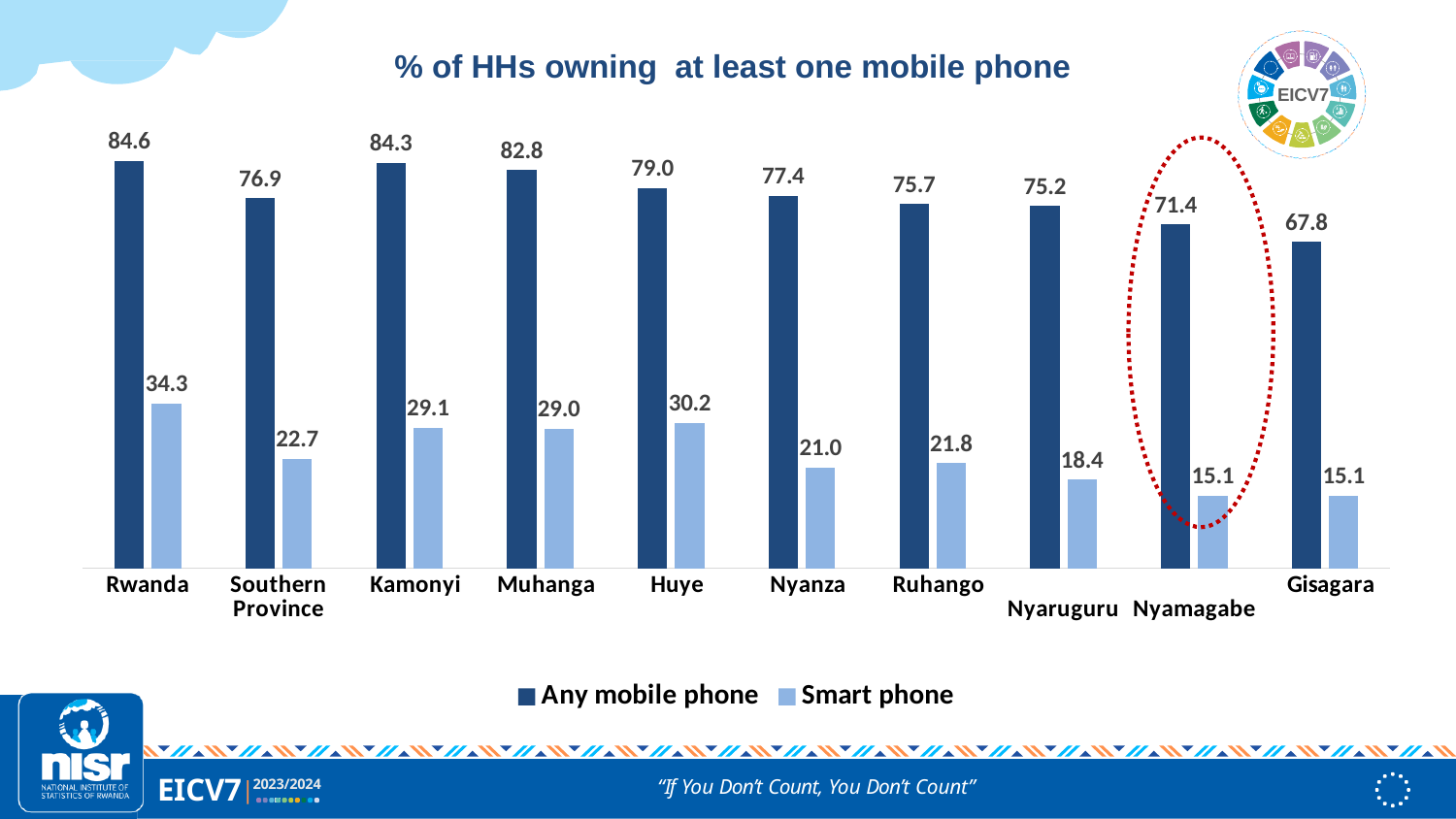
Which is larger, the Smart phone value for Kamonyi or for Nyanza? Kamonyi What is the value for Smart phone in Nyaruguru? 18.4 Which category has the lowest value for Any mobile phone? Gisagara What kind of chart is shown on the slide? Bar chart What is the difference between the Any mobile phone and Smart phone values for Huye? 48.8 What is the value for Any mobile phone in Nyamagabe? 71.4 Which category has the highest value for Smart phone? Rwanda How many categories are shown on the x axis? 10 What is the title of the chart? % of HHs owning at least one mobile phone How many series does the legend list? 2 What is the value for Any mobile phone in Muhanga? 82.8 Do the Any mobile phone values generally rise or fall from Kamonyi to Gisagara along the x axis? Fall